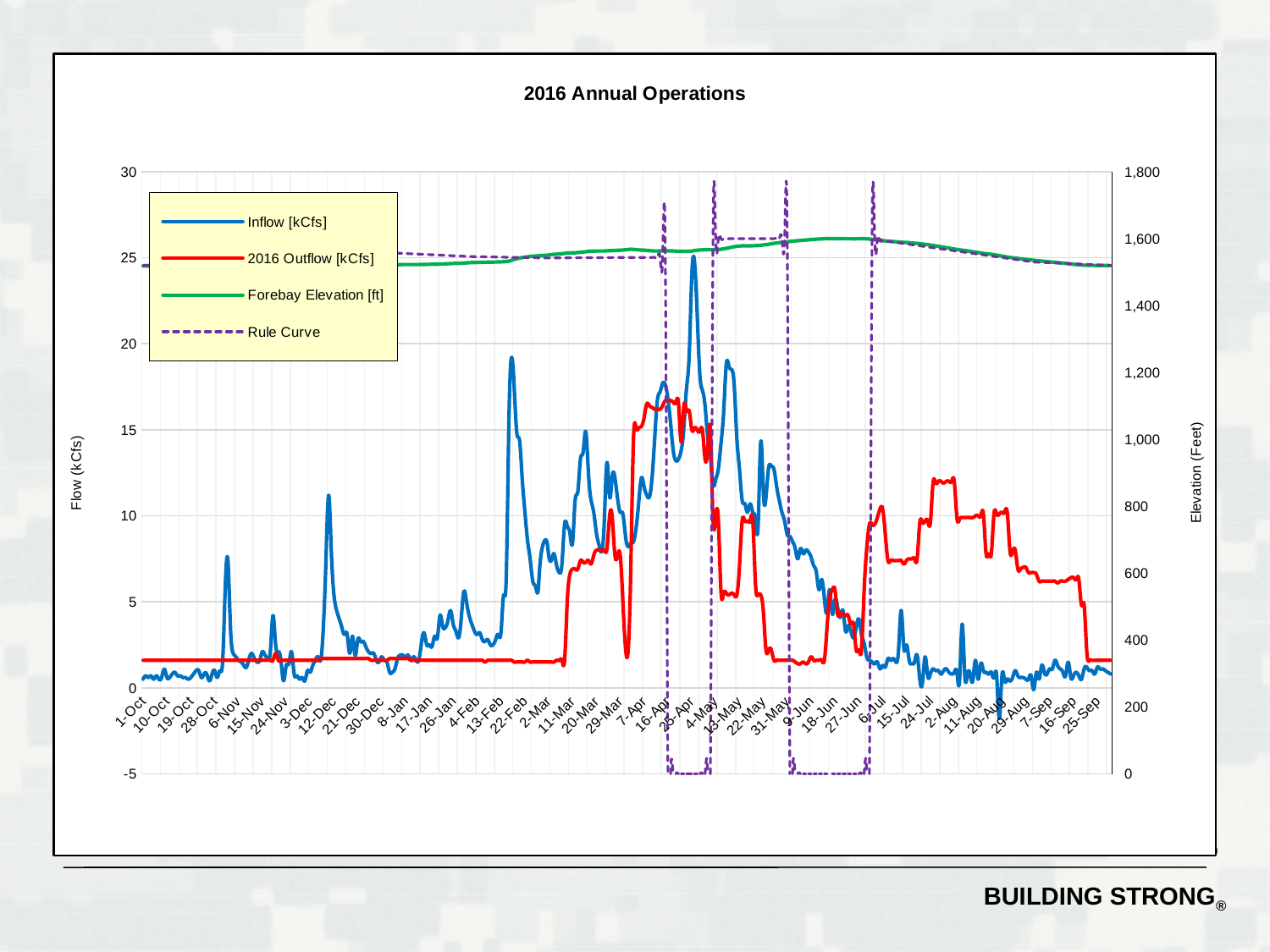
Is the value of 2016 Outflow [kCfs] at 1-Oct greater or less than 5? less Is the value of 2016 Outflow [kCfs] around 2-Aug greater or less than 10? greater Does the Forebay Elevation [ft] rise or fall from mid-June to 25-Sep? fall What is the label of the right-hand vertical axis? Elevation (Feet) Is the Forebay Elevation [ft] around 18-Jun greater or less than 1,400 on the right axis? greater What kind of chart is shown on the slide? line chart Around 2-Aug, which is larger: Inflow [kCfs] or 2016 Outflow [kCfs]? 2016 Outflow [kCfs] What is the title of the chart? 2016 Annual Operations How many series does the legend list? 4 Which flow series reaches the highest value on the left axis: Inflow [kCfs] or 2016 Outflow [kCfs]? Inflow [kCfs]